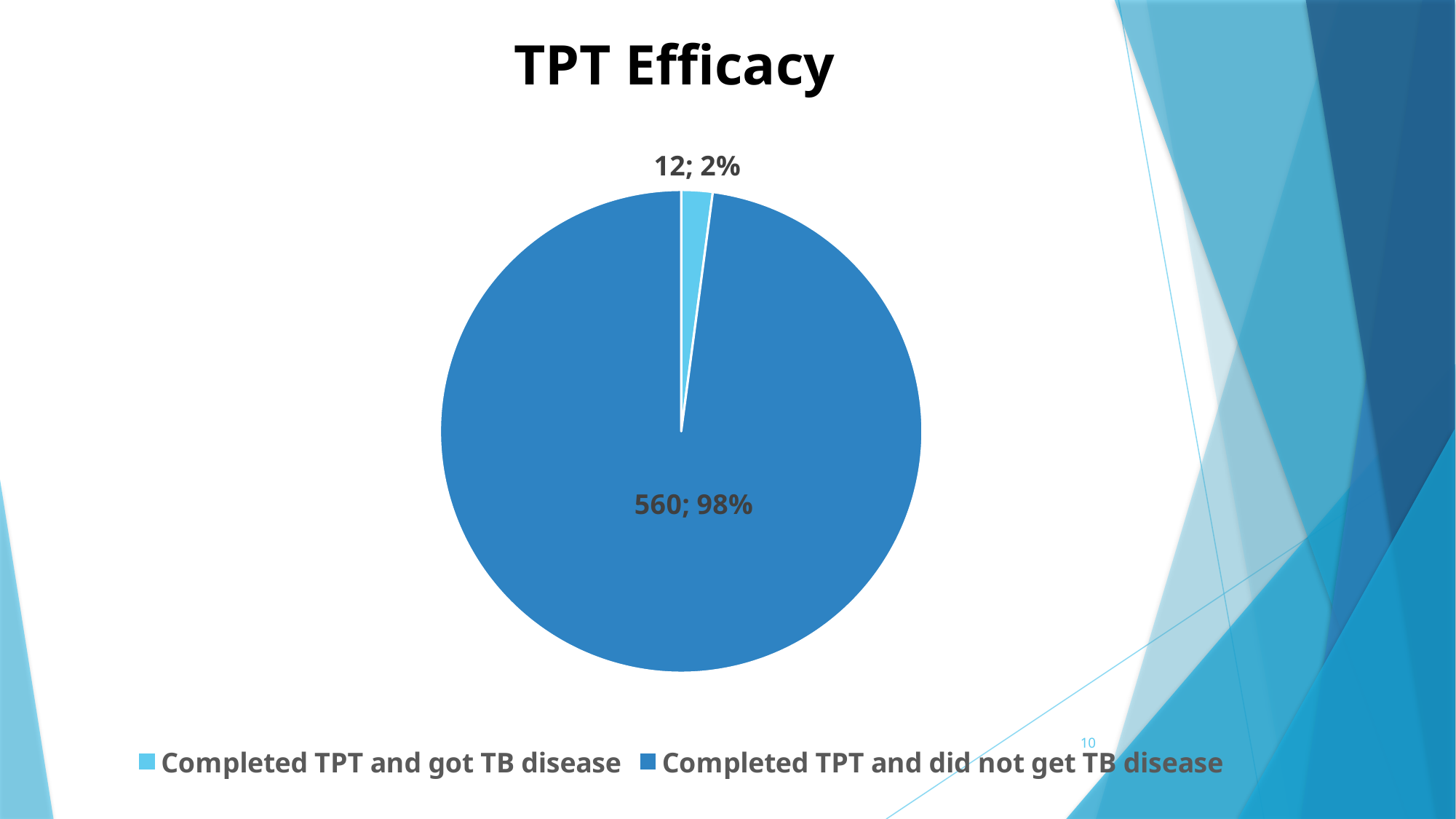
What kind of chart is shown on the slide? pie chart What is the total of the two slice values? 572 What is the value for 'Completed TPT and got TB disease'? 12 What is the title of the chart? TPT Efficacy What is the value for 'Completed TPT and did not get TB disease'? 560 What is the difference between the values for 'Completed TPT and did not get TB disease' and 'Completed TPT and got TB disease'? 548 How many slices does the pie chart have? 2 What share of the pie does 'Completed TPT and did not get TB disease' represent? 98% Which category has the smallest slice? Completed TPT and got TB disease What share of the pie does 'Completed TPT and got TB disease' represent? 2% Which category has the largest slice? Completed TPT and did not get TB disease How many entries does the legend list? 2